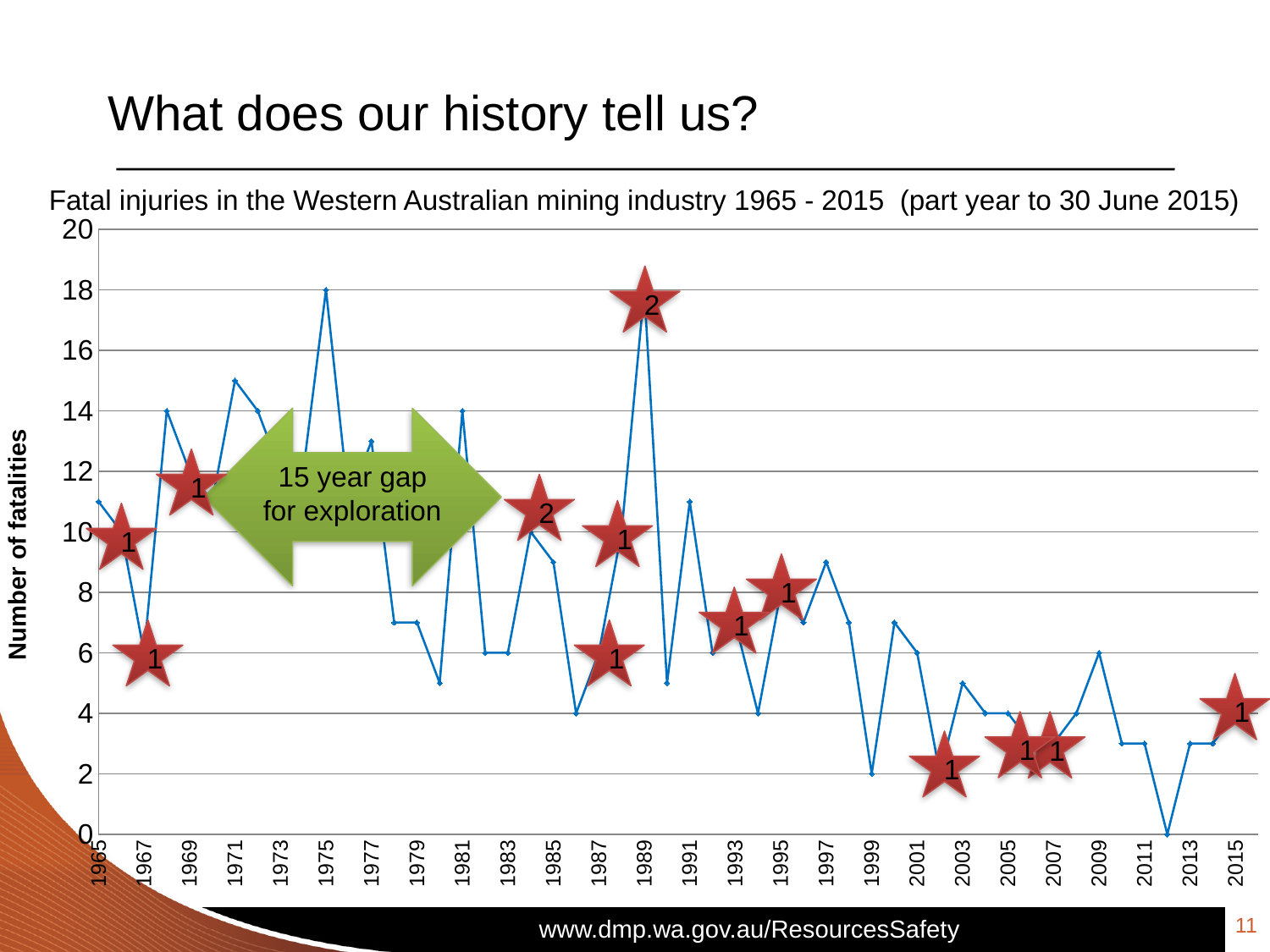
Which year has a lower number of fatalities, 1999 or 2001? 1999 Which year has a higher number of fatalities, 1975 or 1977? 1975 What is the title of the chart? Fatal injuries in the Western Australian mining industry 1965 - 2015 (part year to 30 June 2015) Is the value for 1991 greater or less than 10? greater Is the value for 1975 greater or less than 16? greater Overall, do the number of fatalities rise or fall from 1965 to 2015? fall Is the value for 1965 greater or less than 10? greater What is the label on the vertical axis of the chart? Number of fatalities What kind of chart is shown on the slide? line chart Which year has a higher number of fatalities, 1965 or 2015? 1965